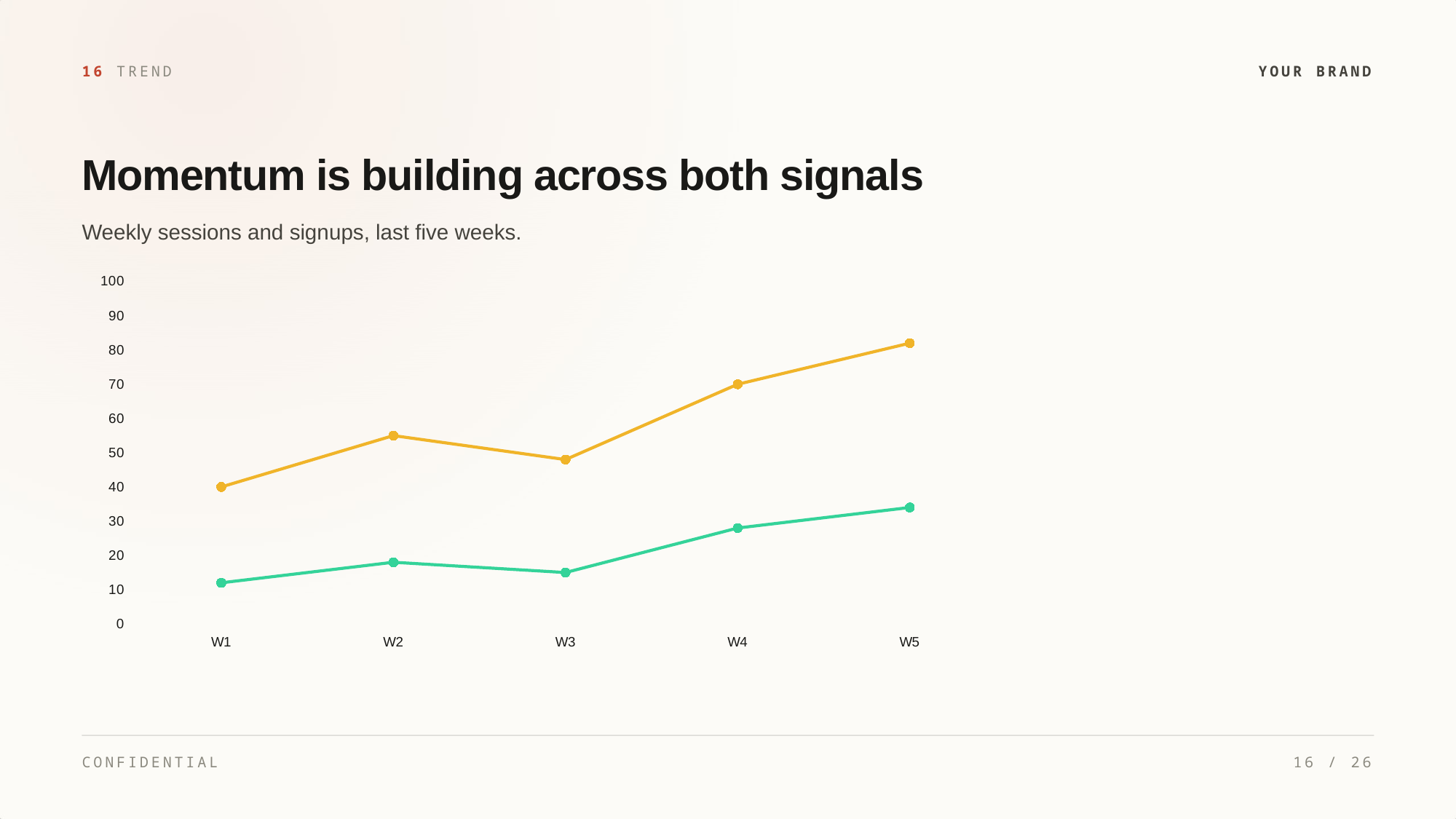
At which week does the orange line reach its highest value? W5 Is the value of the orange line at W5 greater or less than 80? greater Is the value of the orange line at W3 greater or less than 50? less At which week is the green line at its lowest value? W1 Is the value of the green line at W4 greater or less than 30? less What is the value of the orange line at W1? 40 What is the value of the orange line at W4? 70 What kind of chart is shown on the slide? line chart At W3, which line has the higher value, the orange line or the green line? the orange line By how much does the orange line increase from W1 to W4? 30 How many weeks are plotted along the x axis? 5 Do the values of the green line generally rise or fall from W1 to W5? rise